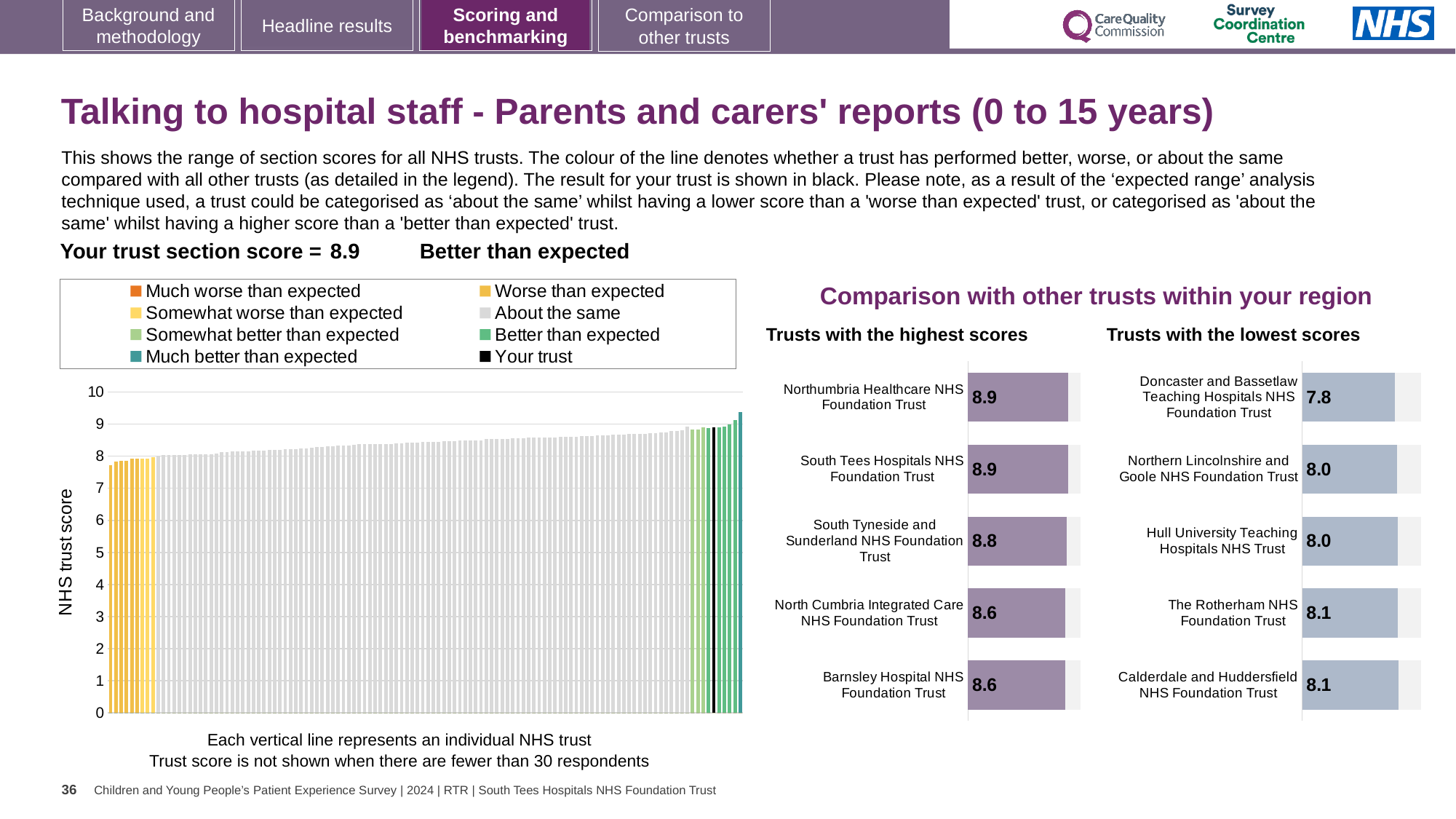
In the 'Trusts with the highest scores' chart, what is the score for South Tyneside and Sunderland NHS Foundation Trust? 8.8 In the 'Trusts with the lowest scores' chart, which trust has the lowest score? Doncaster and Bassetlaw Teaching Hospitals NHS Foundation Trust In the 'Trusts with the highest scores' chart, what is the score for Barnsley Hospital NHS Foundation Trust? 8.6 How many trusts are shown in the 'Trusts with the highest scores' chart? 5 What kind of chart is the NHS trust score chart on the left of the slide? Bar chart In the NHS trust score chart on the left, do the bar values rise or fall from left to right? Rise In the 'Trusts with the lowest scores' chart, how much higher is the score of Calderdale and Huddersfield NHS Foundation Trust than that of Doncaster and Bassetlaw Teaching Hospitals NHS Foundation Trust? 0.3 In the 'Trusts with the lowest scores' chart, what is the score for Doncaster and Bassetlaw Teaching Hospitals NHS Foundation Trust? 7.8 In the NHS trust score chart on the left, is the value of the black 'Your trust' bar greater or less than 8? greater How many entries does the legend of the NHS trust score chart on the left list? 8 In the 'Trusts with the lowest scores' chart, which has the higher score: Hull University Teaching Hospitals NHS Trust or The Rotherham NHS Foundation Trust? The Rotherham NHS Foundation Trust In the 'Trusts with the highest scores' chart, what is the difference between the scores of Northumbria Healthcare NHS Foundation Trust and North Cumbria Integrated Care NHS Foundation Trust? 0.3